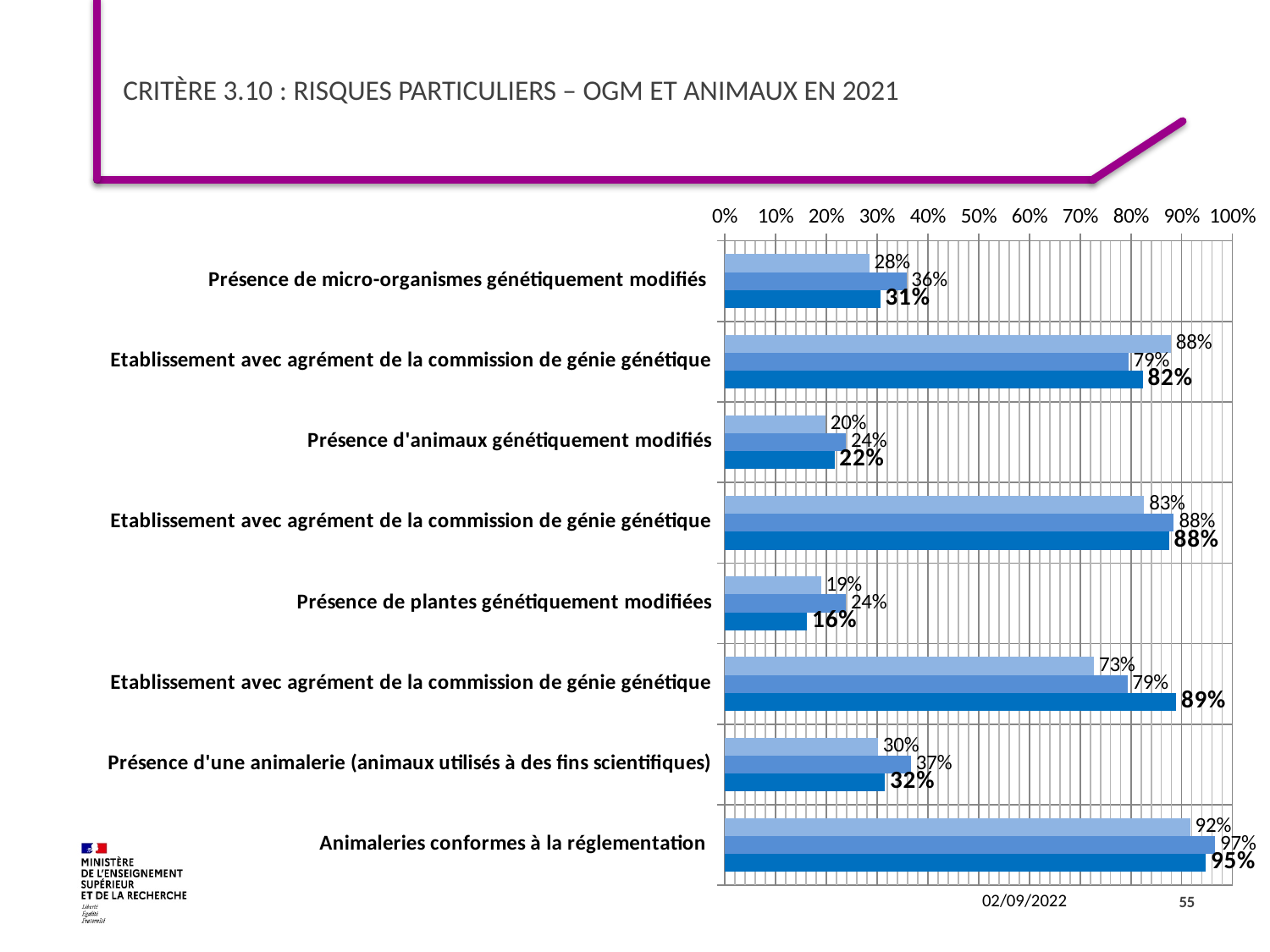
How many categories are listed on the vertical axis of the chart? 8 What is the bold value (bottom bar) for the second category from the top, 'Etablissement avec agrément de la commission de génie génétique'? 82% What is the value of the middle bar for 'Présence d'une animalerie (animaux utilisés à des fins scientifiques)'? 37% What is the value of the top (light blue) bar for 'Présence de micro-organismes génétiquement modifiés'? 28% What is the bold value (bottom, dark blue bar) for 'Animaleries conformes à la réglementation'? 95% For 'Animaleries conformes à la réglementation', what is the difference between the middle bar (97%) and the top bar (92%)? 5 percentage points Which category has the highest bold (bottom bar) value? Animaleries conformes à la réglementation Which has the larger bold (bottom bar) value: 'Présence d'animaux génétiquement modifiés' or 'Présence de plantes génétiquement modifiées'? Présence d'animaux génétiquement modifiés Is the bold (bottom bar) value for 'Présence d'une animalerie (animaux utilisés à des fins scientifiques)' greater or less than 50%? less What type of chart is shown on the slide? bar chart How many bars are plotted for each category in the chart? 3 Which category has the lowest bold (bottom bar) value? Présence de plantes génétiquement modifiées